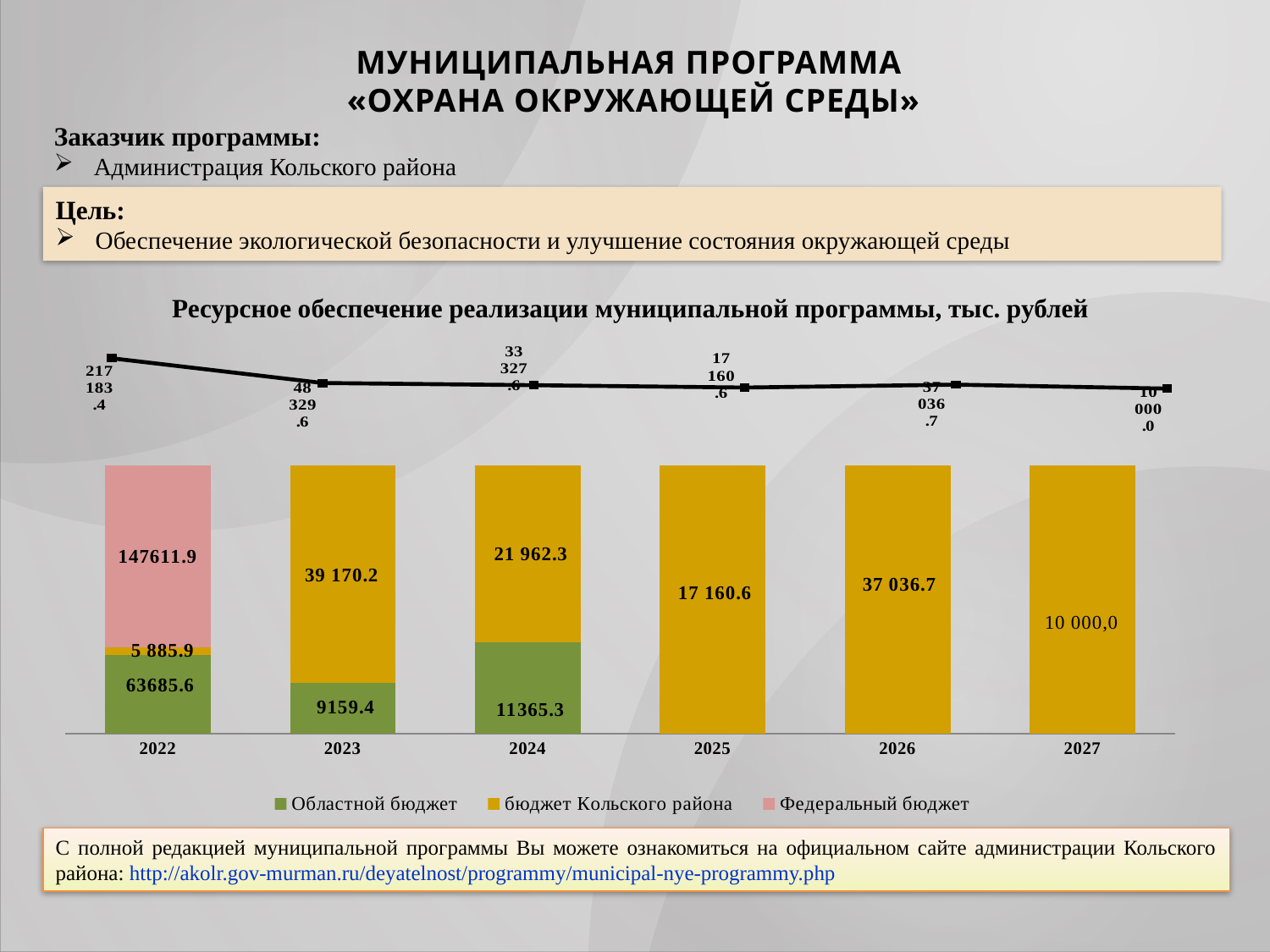
What is the value for бюджет Кольского района in 2023? 39 170.2 What is the difference between бюджет Кольского района and Областной бюджет in 2024? 10 597.0 What is the value for бюджет Кольского района in 2027? 10 000,0 How many years are shown on the x axis? 6 What is the value for Областной бюджет in 2022? 63685.6 In 2023, which is larger: бюджет Кольского района or Областной бюджет? бюджет Кольского района What is the total of the stacked bar for 2023? 48 329.6 Which year has the highest total funding according to the line labels? 2022 What is the value for бюджет Кольского района in 2026? 37 036.7 What kind of chart is used to show the budget breakdown? Stacked bar chart What is the value for Федеральный бюджет in 2022? 147611.9 How many series does the legend list? 3